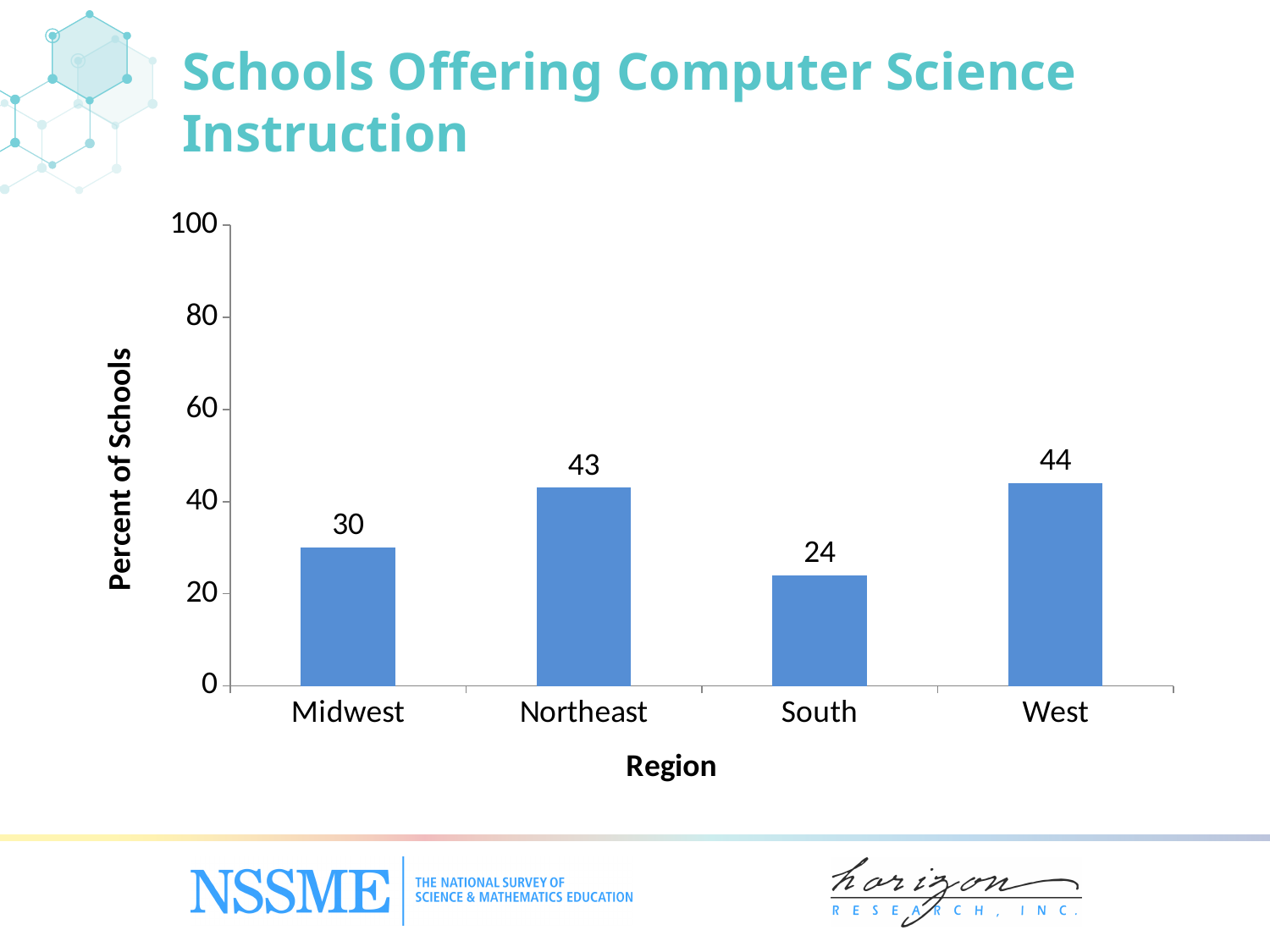
How many regions are shown on the x axis? 4 What percent of schools in the Midwest offer computer science instruction? 30 What is the label of the y axis? Percent of Schools What is the difference between the values for the Northeast and the Midwest? 13 What is the value shown for the South region? 24 Which region has the highest percent of schools offering computer science instruction? West Which region has the lowest percent of schools offering computer science instruction? South Which region has a larger value, Midwest or South? Midwest What is the value shown for the Northeast region? 43 Is the value for the Northeast greater or less than 40? greater What kind of chart is shown on the slide? bar chart What is the difference between the values for the West and the South? 20